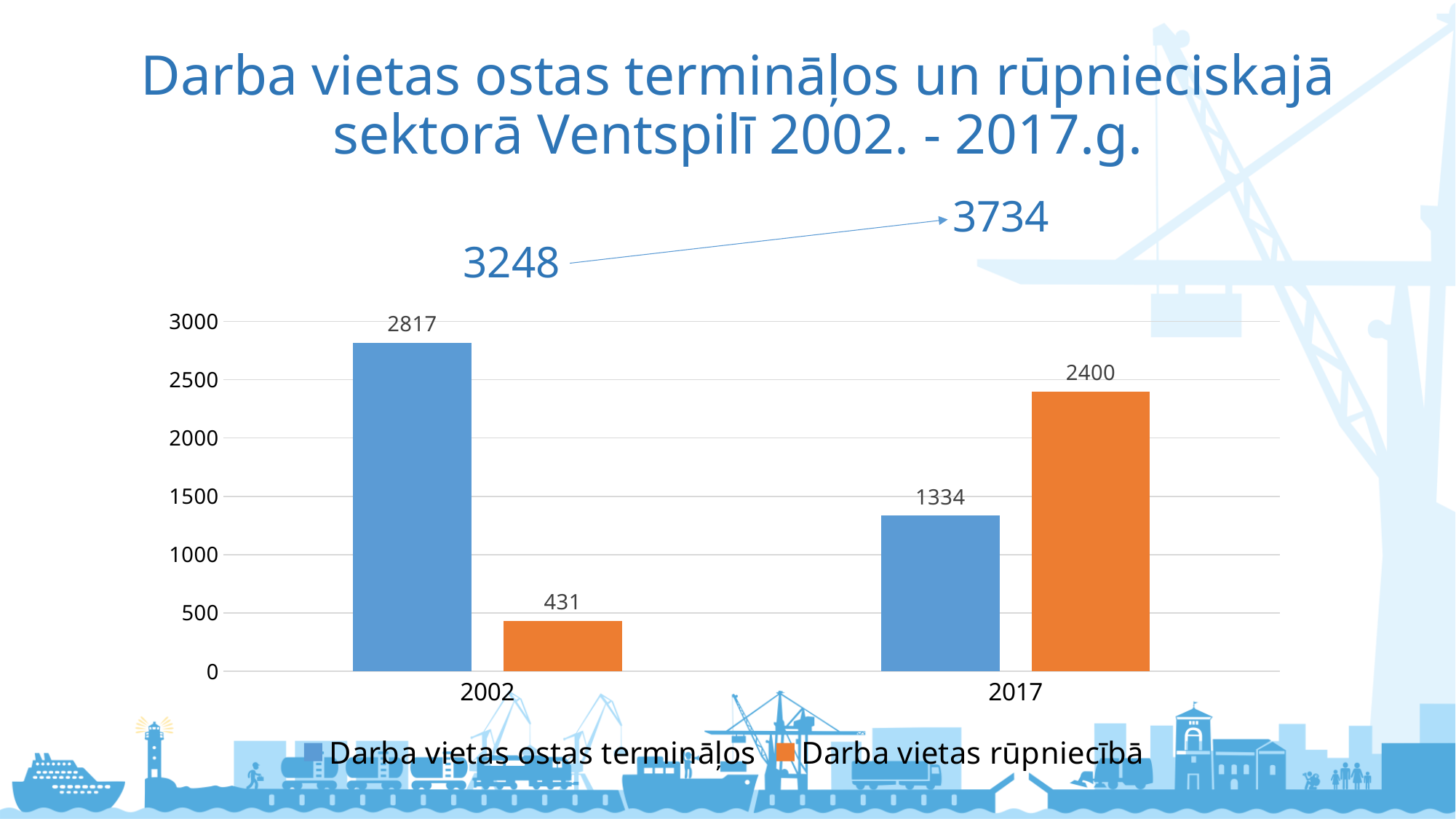
Which bar has the highest value on the chart? Darba vietas ostas terminālos in 2002 What is the value for Darba vietas ostas terminālos in 2002? 2817 What is the value for Darba vietas rūpniecībā in 2017? 2400 Which bar has the lowest value on the chart? Darba vietas rūpniecībā in 2002 Which is larger in 2017: Darba vietas ostas terminālos or Darba vietas rūpniecībā? Darba vietas rūpniecībā What is the difference between Darba vietas rūpniecībā in 2017 and in 2002? 1969 What is the value for Darba vietas ostas terminālos in 2017? 1334 What kind of chart is shown on the slide? Bar chart What is the total of the two series for 2017, as printed above the chart? 3734 What is the value for Darba vietas rūpniecībā in 2002? 431 How many series does the legend list? 2 How many categories are shown on the x axis? 2